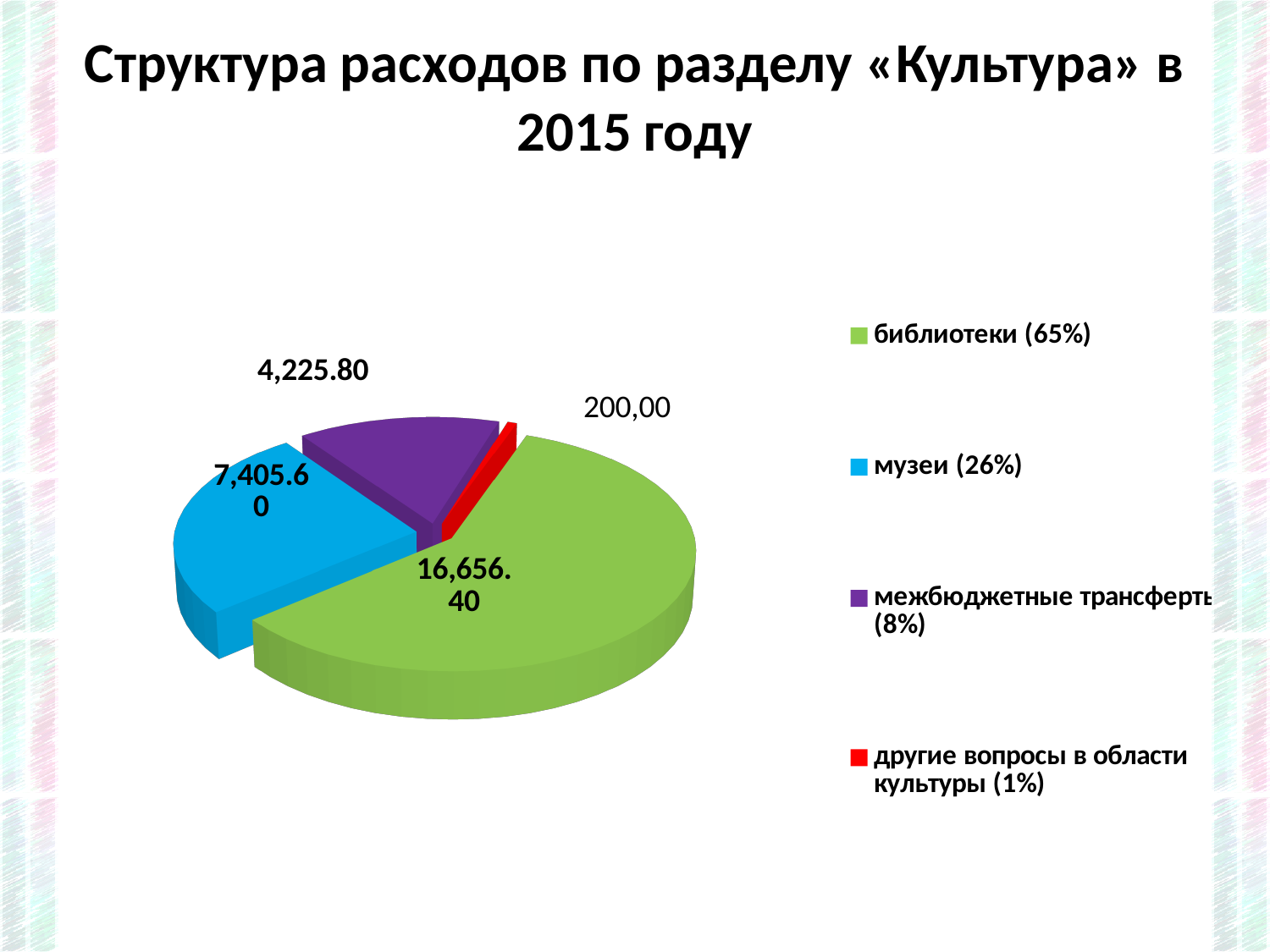
What share of the pie do межбюджетные трансферты account for? 8% What kind of chart is shown on the slide? pie chart What is the value shown for библиотеки? 16,656.40 What is the value shown for другие вопросы в области культуры? 200,00 What is the value shown for музеи? 7,405.60 What share of the pie do музеи account for? 26% What is the difference between the values for библиотеки and музеи? 9,250.80 What is the value shown for межбюджетные трансферты? 4,225.80 Which category has the smallest slice of the pie? другие вопросы в области культуры Which category has the largest slice of the pie? библиотеки How many categories does the pie chart have? 4 Which is larger, the value for музеи or the value for межбюджетные трансферты? музеи